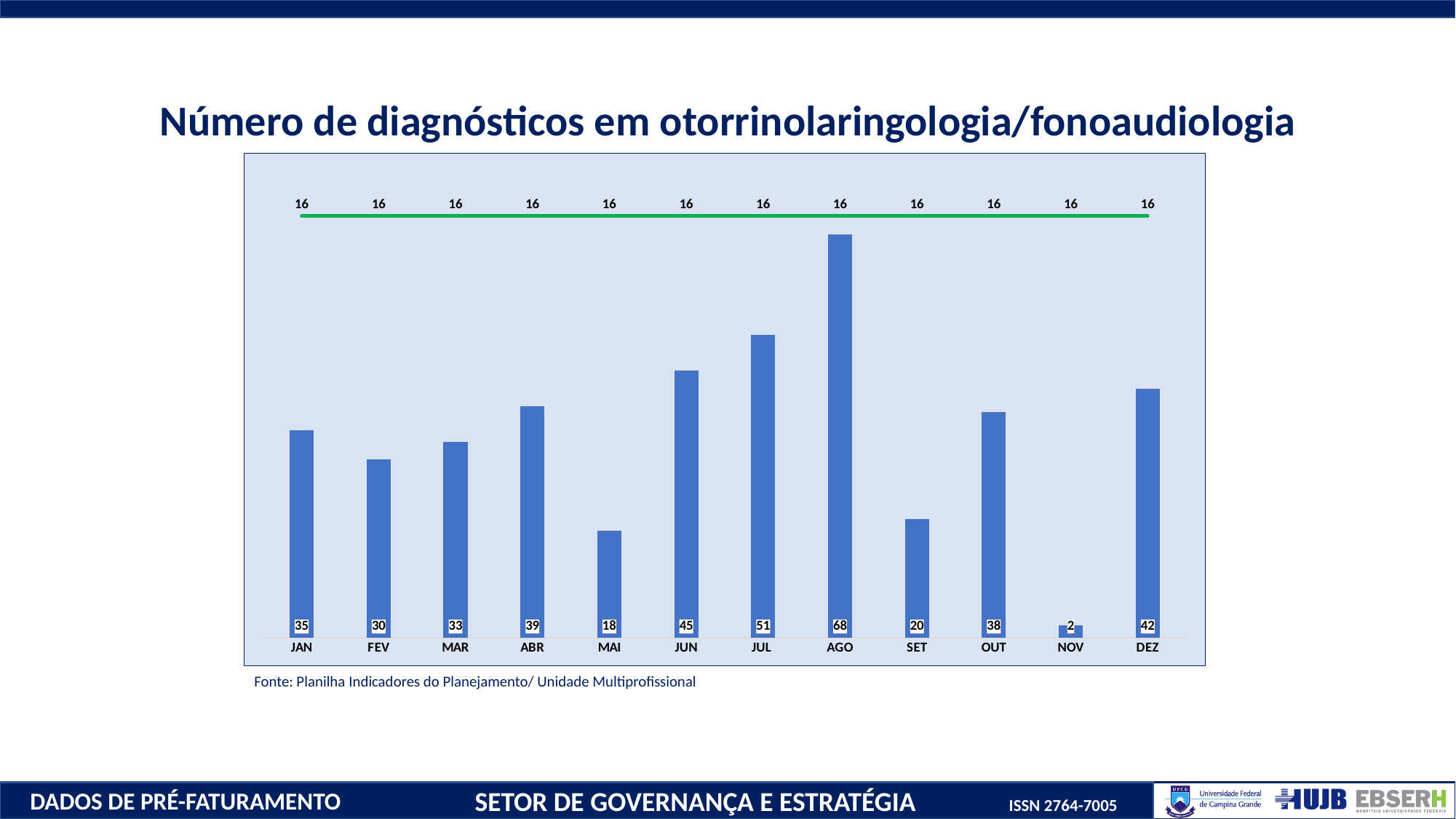
What is the number of diagnoses for MAI? 18 Which month has the lowest number of diagnoses? NOV What is the difference between the values for DEZ and SET? 22 What is the number of diagnoses for AGO? 68 What is the number of diagnoses for NOV? 2 Which is larger, the value for ABR or the value for OUT? ABR Which month has the highest number of diagnoses? AGO What kind of chart is shown on the slide? Bar chart with a line What constant value does the green line show for every month? 16 What is the difference between the values for JUL and JUN? 6 How many months are shown on the x axis? 12 What is the title of the chart? Número de diagnósticos em otorrinolaringologia/fonoaudiologia